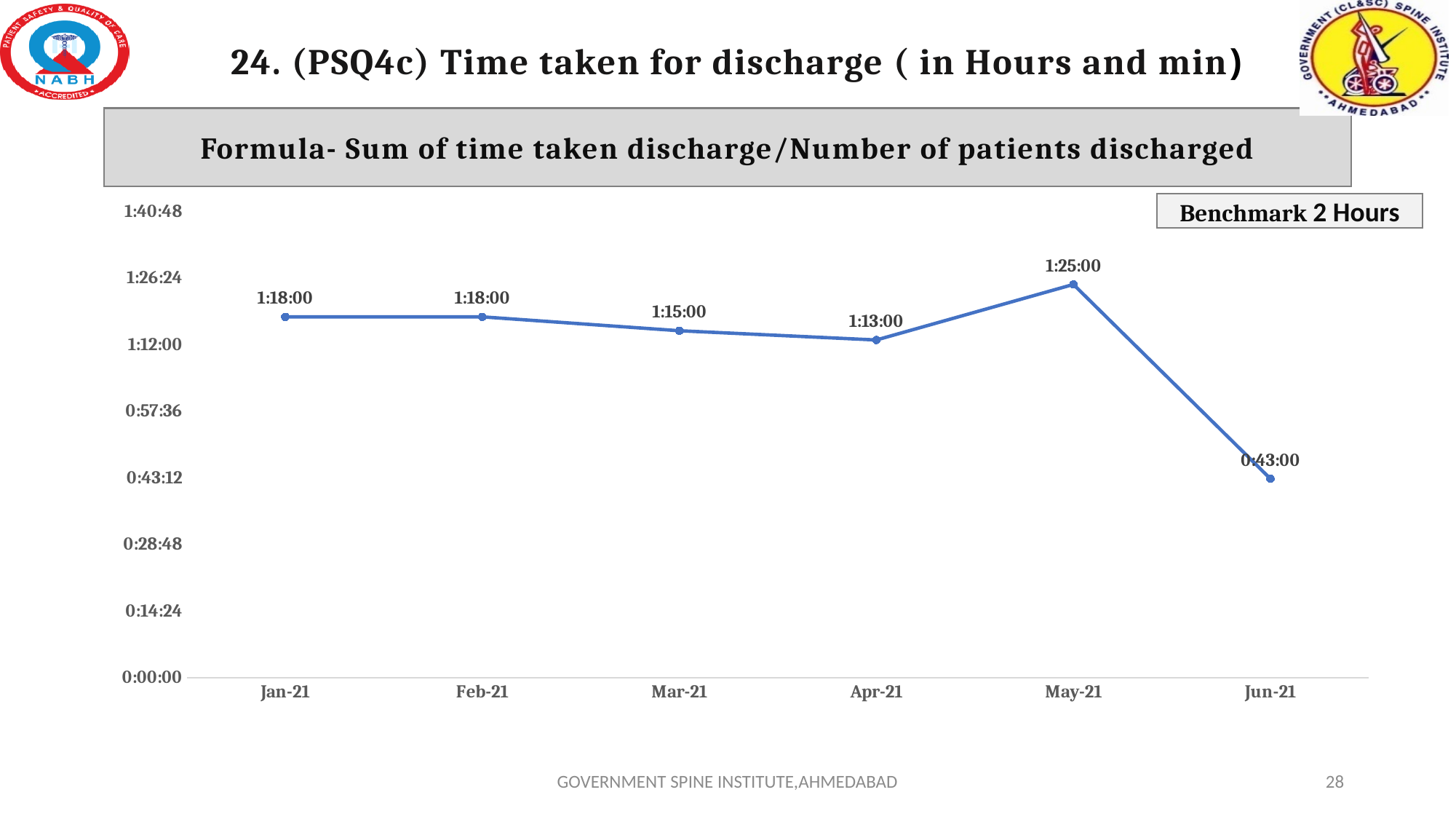
How many months are plotted on the chart? 6 What is the time taken for discharge in Apr-21? 1:13:00 Which month has the highest time taken for discharge? May-21 What is the time taken for discharge in May-21? 1:25:00 Is the value for Jun-21 greater or less than 0:57:36? less Is the time taken for discharge higher in May-21 or in Apr-21? May-21 What benchmark is stated on the slide for time taken for discharge? 2 Hours What kind of chart is shown on the slide? Line chart Which month has the lowest time taken for discharge? Jun-21 What is the time taken for discharge in Jun-21? 0:43:00 Does the time taken for discharge rise or fall from May-21 to Jun-21? Fall What is the time taken for discharge in Mar-21? 1:15:00